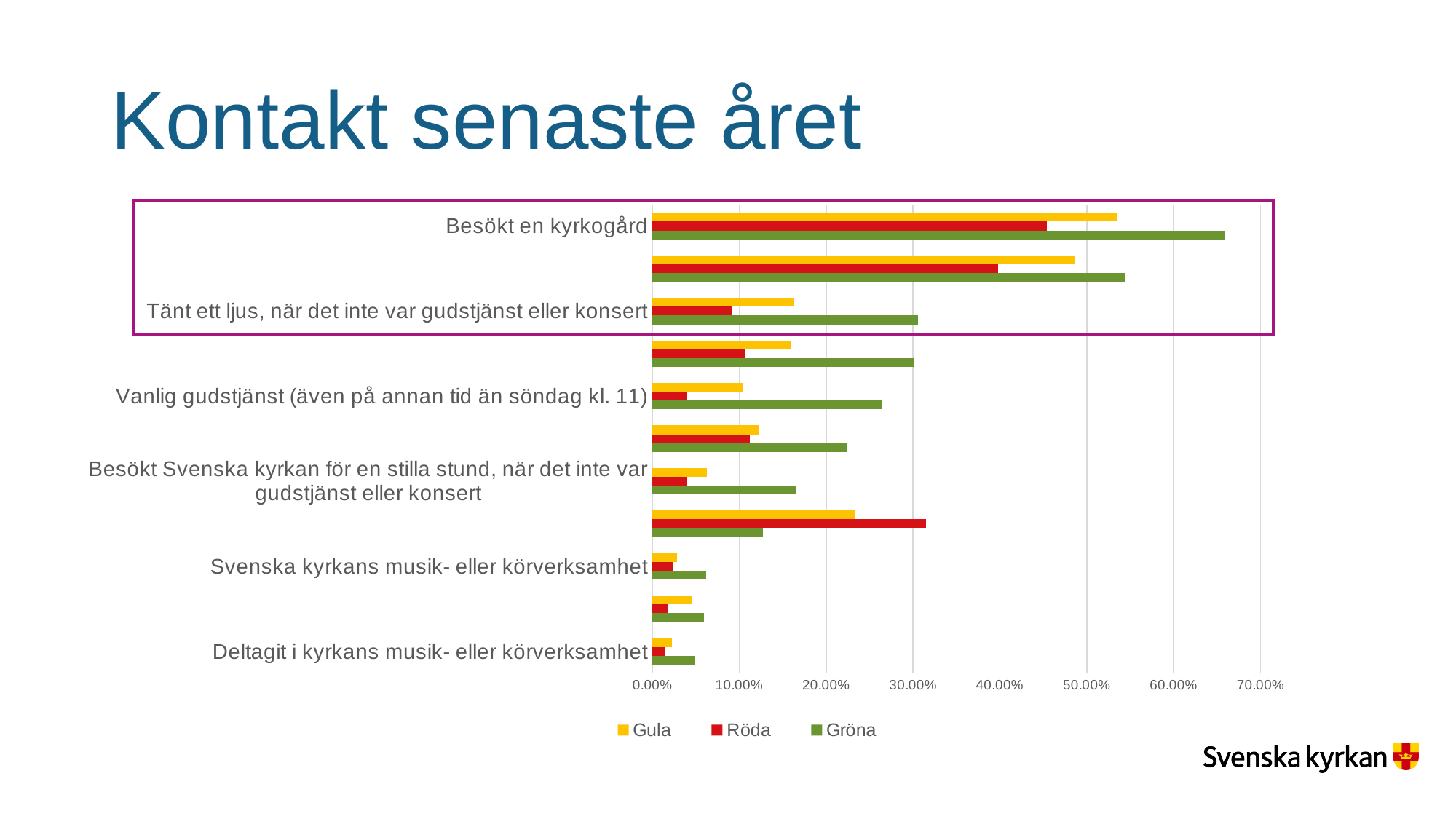
Which series are listed in the legend? Gula, Röda, Gröna Which labelled category has the highest Gröna value? Besökt en kyrkogård How many series does the legend list? 3 Is the Gröna value for 'Tänt ett ljus, när det inte var gudstjänst eller konsert' greater or less than 20.00%? greater For 'Besökt en kyrkogård', which series has the highest value? Gröna Is the Gröna value for 'Vanlig gudstjänst (även på annan tid än söndag kl. 11)' greater or less than 20.00%? greater Is the Gula value for 'Tänt ett ljus, när det inte var gudstjänst eller konsert' greater or less than 10.00%? greater What kind of chart is shown on the slide? bar chart